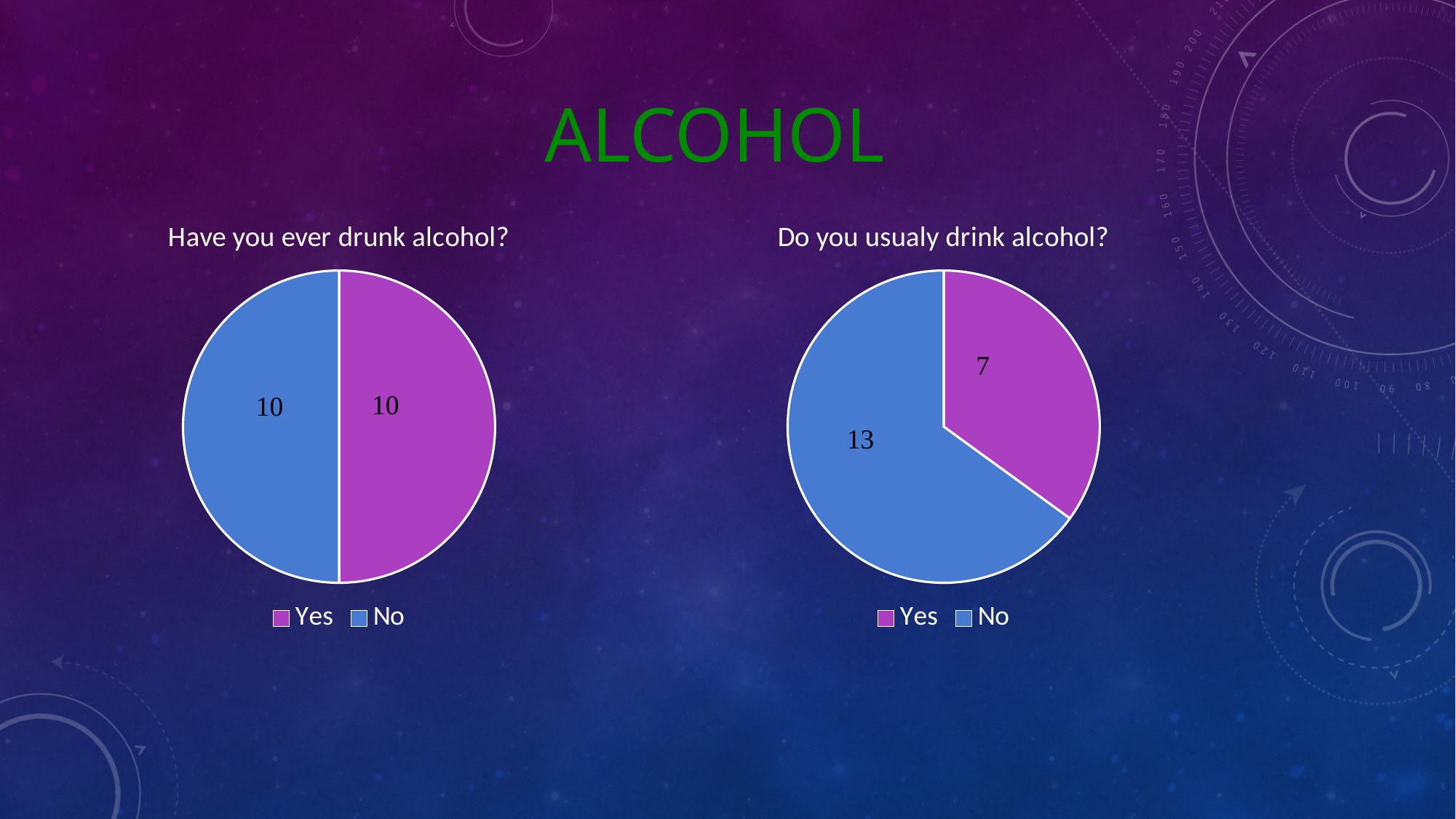
In the "Do you usualy drink alcohol?" chart, which answer has the smallest slice? Yes In the "Do you usualy drink alcohol?" chart, what share of the pie does the Yes slice represent? 35% How many slices does the "Do you usualy drink alcohol?" chart have? 2 In the "Have you ever drunk alcohol?" chart, what is the value for No? 10 In the "Do you usualy drink alcohol?" chart, what colour is the No slice? Blue In the "Have you ever drunk alcohol?" chart, what is the value for Yes? 10 In the "Do you usualy drink alcohol?" chart, which answer has the largest slice? No In the "Do you usualy drink alcohol?" chart, what is the value for Yes? 7 In the "Do you usualy drink alcohol?" chart, what is the value for No? 13 What kind of chart is the "Have you ever drunk alcohol?" chart? Pie chart In the "Have you ever drunk alcohol?" chart, what share of the pie does the No slice represent? 50% In the "Do you usualy drink alcohol?" chart, what is the difference between the No and Yes values? 6